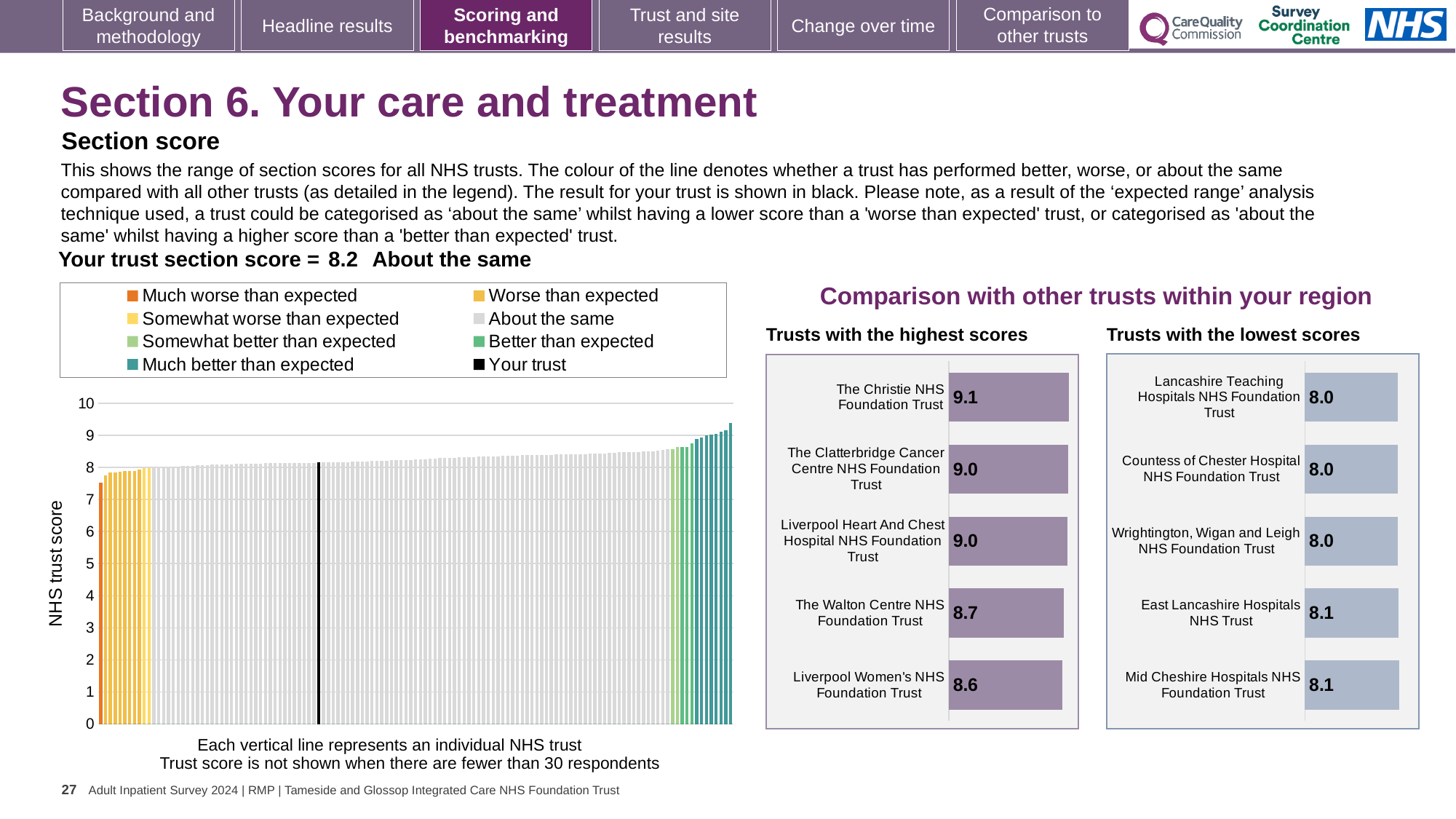
In the 'Trusts with the highest scores' chart, what is the score for The Christie NHS Foundation Trust? 9.1 In the 'Trusts with the highest scores' chart, what is the difference between the scores of The Christie NHS Foundation Trust and Liverpool Women's NHS Foundation Trust? 0.5 In the 'Trusts with the highest scores' chart, which trust has the highest score? The Christie NHS Foundation Trust In the 'Trusts with the highest scores' chart, which trust has the lowest score? Liverpool Women's NHS Foundation Trust What kind of chart is the large 'NHS trust score' chart on the left of the slide? bar chart How many entries does the legend of the large 'NHS trust score' chart on the left list? 8 In the 'Trusts with the lowest scores' chart, what is the score for Wrightington, Wigan and Leigh NHS Foundation Trust? 8.0 In the 'Trusts with the highest scores' chart, which has the larger score: The Walton Centre NHS Foundation Trust or Liverpool Women's NHS Foundation Trust? The Walton Centre NHS Foundation Trust In the 'Trusts with the lowest scores' chart, what is the score for East Lancashire Hospitals NHS Trust? 8.1 How many trusts are shown in the 'Trusts with the highest scores' chart? 5 In the large 'NHS trust score' chart on the left, do the values rise or fall from left to right? rise In the 'Trusts with the highest scores' chart, what is the score for The Walton Centre NHS Foundation Trust? 8.7